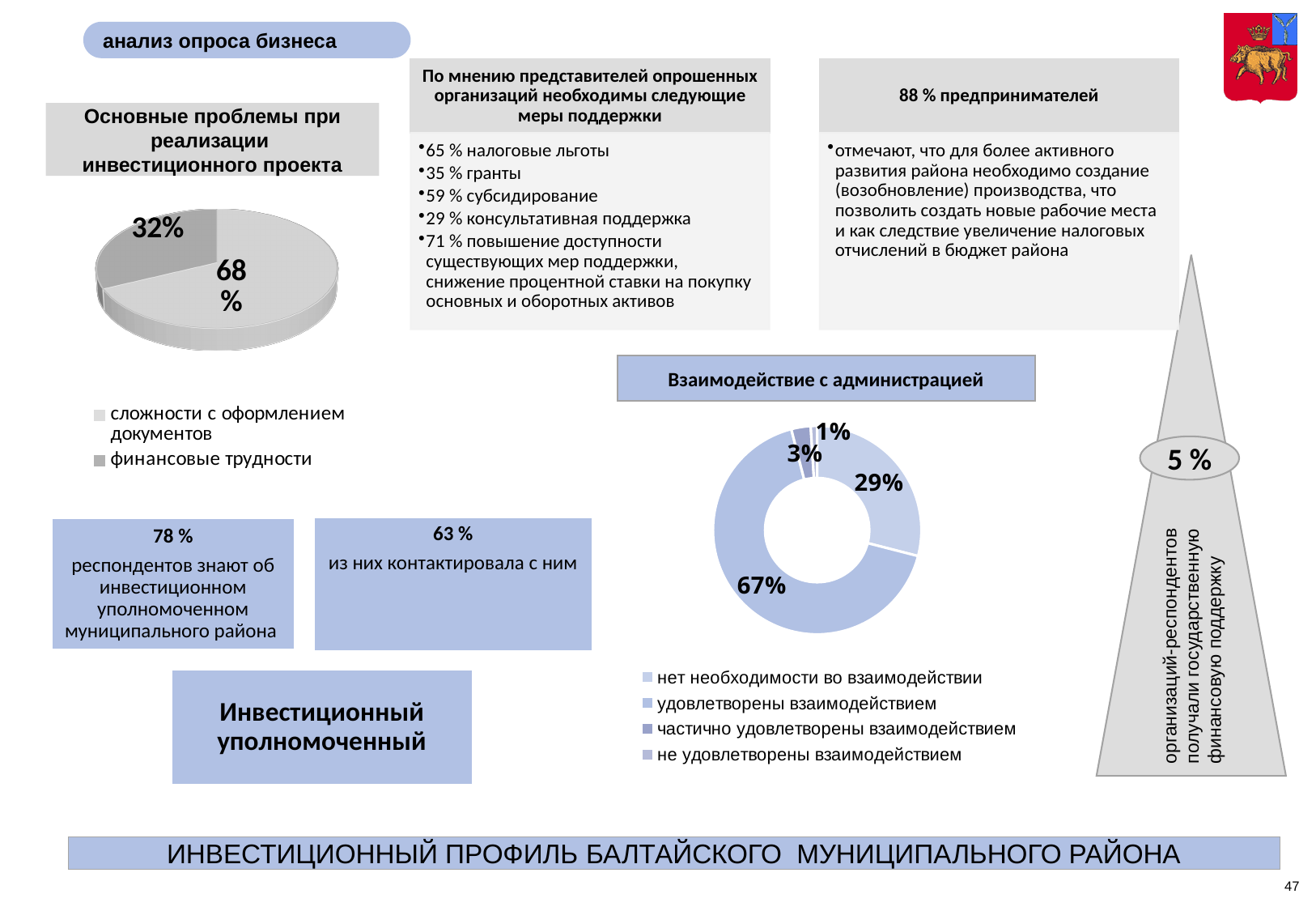
In the chart 'Взаимодействие с администрацией', what share is labelled for 'не удовлетворены взаимодействием'? 1% What type of chart is used for 'Основные проблемы при реализации инвестиционного проекта'? pie chart In the pie chart 'Основные проблемы при реализации инвестиционного проекта', what is the difference in percentage points between the two slices? 36 In the pie chart 'Основные проблемы при реализации инвестиционного проекта', which category has the largest share? сложности с оформлением документов In the pie chart 'Основные проблемы при реализации инвестиционного проекта', what share is labelled for 'финансовые трудности'? 32% In the chart 'Взаимодействие с администрацией', what share is labelled for 'нет необходимости во взаимодействии'? 29% In the chart 'Взаимодействие с администрацией', which is larger: 'частично удовлетворены взаимодействием' or 'нет необходимости во взаимодействии'? нет необходимости во взаимодействии In the pie chart 'Основные проблемы при реализации инвестиционного проекта', what share is labelled for 'сложности с оформлением документов'? 68% In the pie chart 'Основные проблемы при реализации инвестиционного проекта', how many categories does the legend list? 2 In the chart 'Взаимодействие с администрацией', how many categories does the legend list? 4 In the chart 'Взаимодействие с администрацией', what share is labelled for 'удовлетворены взаимодействием'? 67% In the chart 'Взаимодействие с администрацией', which category has the smallest share? не удовлетворены взаимодействием